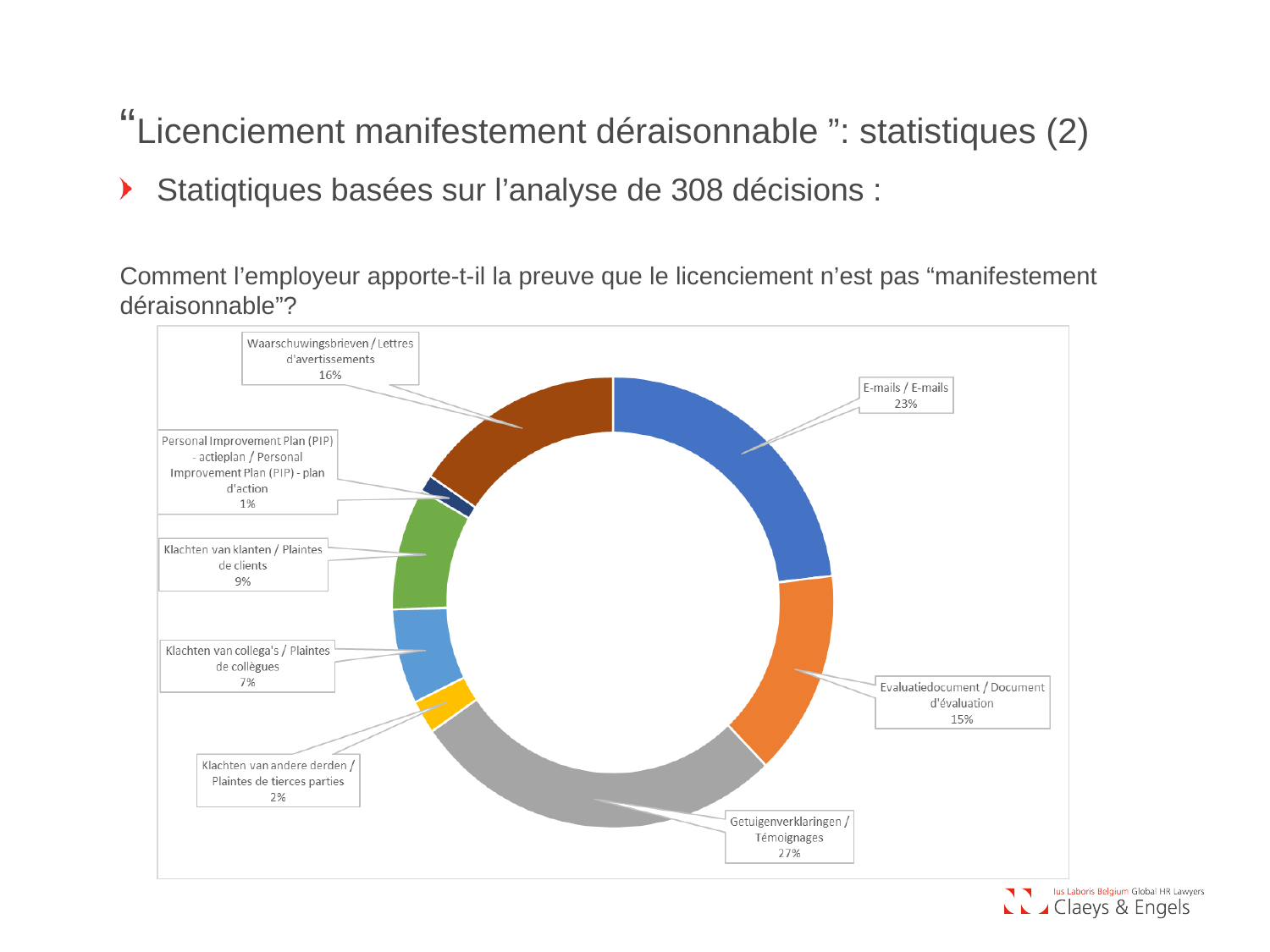
What percentage is shown for "E-mails / E-mails"? 23% Which category has the largest share of the doughnut chart? Getuigenverklaringen / Témoignages What kind of chart is shown on the slide? Doughnut chart Which is larger: the share for "Waarschuwingsbrieven / Lettres d'avertissements" or the share for "Evaluatiedocument / Document d'évaluation"? Waarschuwingsbrieven / Lettres d'avertissements What percentage is shown for "Evaluatiedocument / Document d'évaluation"? 15% What is the difference in percentage points between "Getuigenverklaringen / Témoignages" and "E-mails / E-mails"? 4 What percentage is shown for "Klachten van klanten / Plaintes de clients"? 9% What is the combined percentage of "Klachten van collega's / Plaintes de collègues" and "Klachten van andere derden / Plaintes de tierces parties"? 9% What colour is the segment for "Klachten van klanten / Plaintes de clients"? Green Which category has the smallest share of the doughnut chart? Personal Improvement Plan (PIP) - actieplan / Personal Improvement Plan (PIP) - plan d'action What percentage is shown for "Getuigenverklaringen / Témoignages"? 27% How many categories are shown in the doughnut chart? 8